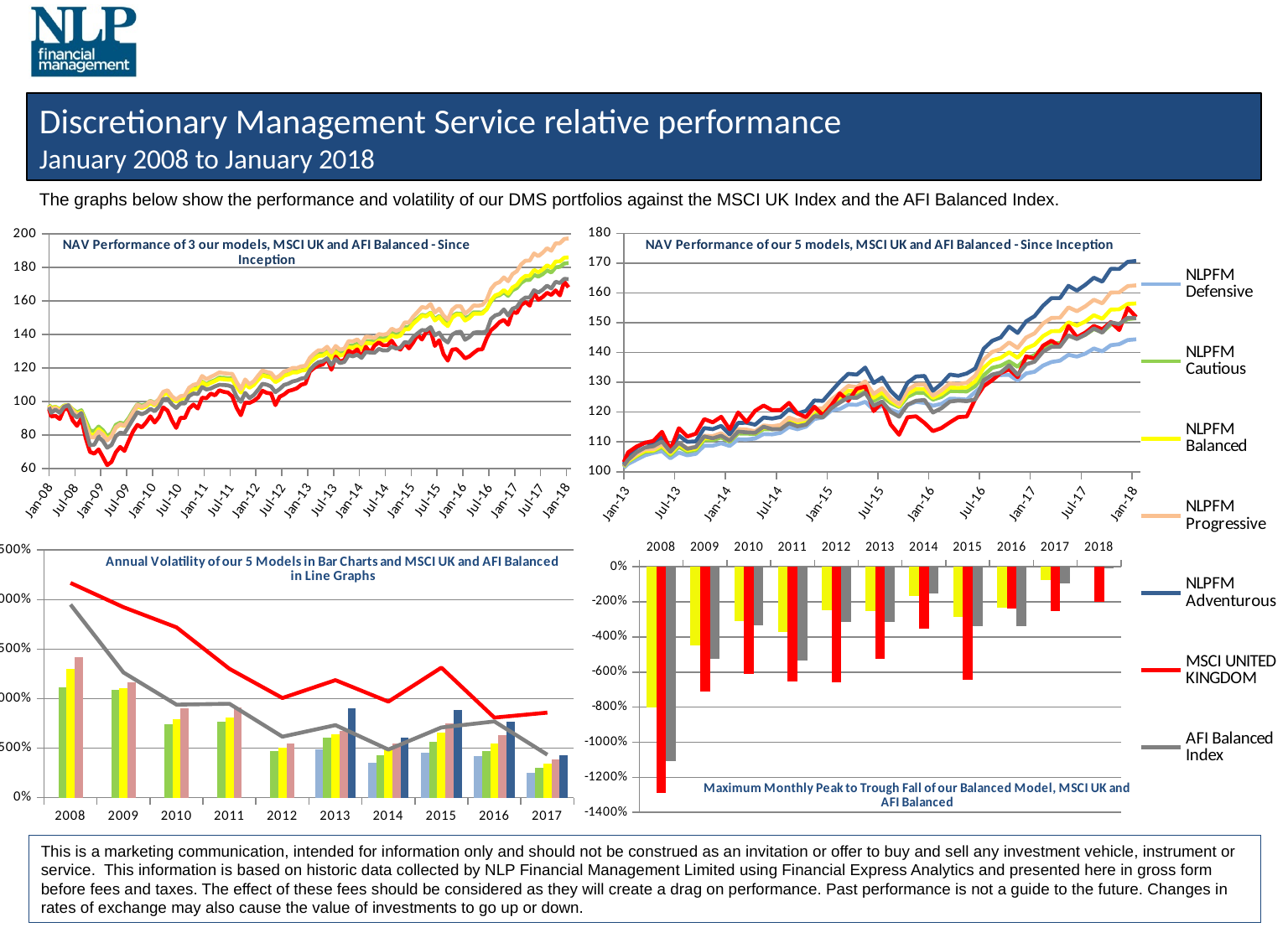
In the top-right chart 'NAV Performance of our 5 models, MSCI UK and AFI Balanced - Since Inception', which series is lowest at Jan-18? NLPFM Defensive How many series does the shared legend on the right of the slide list? 7 What kind of chart is the top-left chart titled 'NAV Performance of 3 our models, MSCI UK and AFI Balanced - Since Inception'? Line chart In the bottom-left chart 'Annual Volatility of our 5 Models in Bar Charts and MSCI UK and AFI Balanced in Line Graphs', in which year is the MSCI UNITED KINGDOM line highest? 2008 In the bottom-right chart 'Maximum Monthly Peak to Trough Fall of our Balanced Model, MSCI UK and AFI Balanced', which year shows the largest fall for MSCI UNITED KINGDOM? 2008 In the top-left chart 'NAV Performance of 3 our models, MSCI UK and AFI Balanced - Since Inception', is the value for MSCI UNITED KINGDOM at Jan-09 greater or less than 80? less In the top-left chart 'NAV Performance of 3 our models, MSCI UK and AFI Balanced - Since Inception', which series is highest at Jan-18? NLPFM Progressive In the top-right chart 'NAV Performance of our 5 models, MSCI UK and AFI Balanced - Since Inception', is the value for NLPFM Adventurous at Jan-18 greater or less than 160? greater In the top-right chart 'NAV Performance of our 5 models, MSCI UK and AFI Balanced - Since Inception', which series is highest at Jan-18? NLPFM Adventurous What kind of chart is the bottom-right chart titled 'Maximum Monthly Peak to Trough Fall of our Balanced Model, MSCI UK and AFI Balanced'? Bar chart In the top-left chart 'NAV Performance of 3 our models, MSCI UK and AFI Balanced - Since Inception', do the values generally rise or fall from Jan-09 to Jan-18? Rise How many years are shown on the x axis of the bottom-left chart 'Annual Volatility of our 5 Models in Bar Charts and MSCI UK and AFI Balanced in Line Graphs'? 10